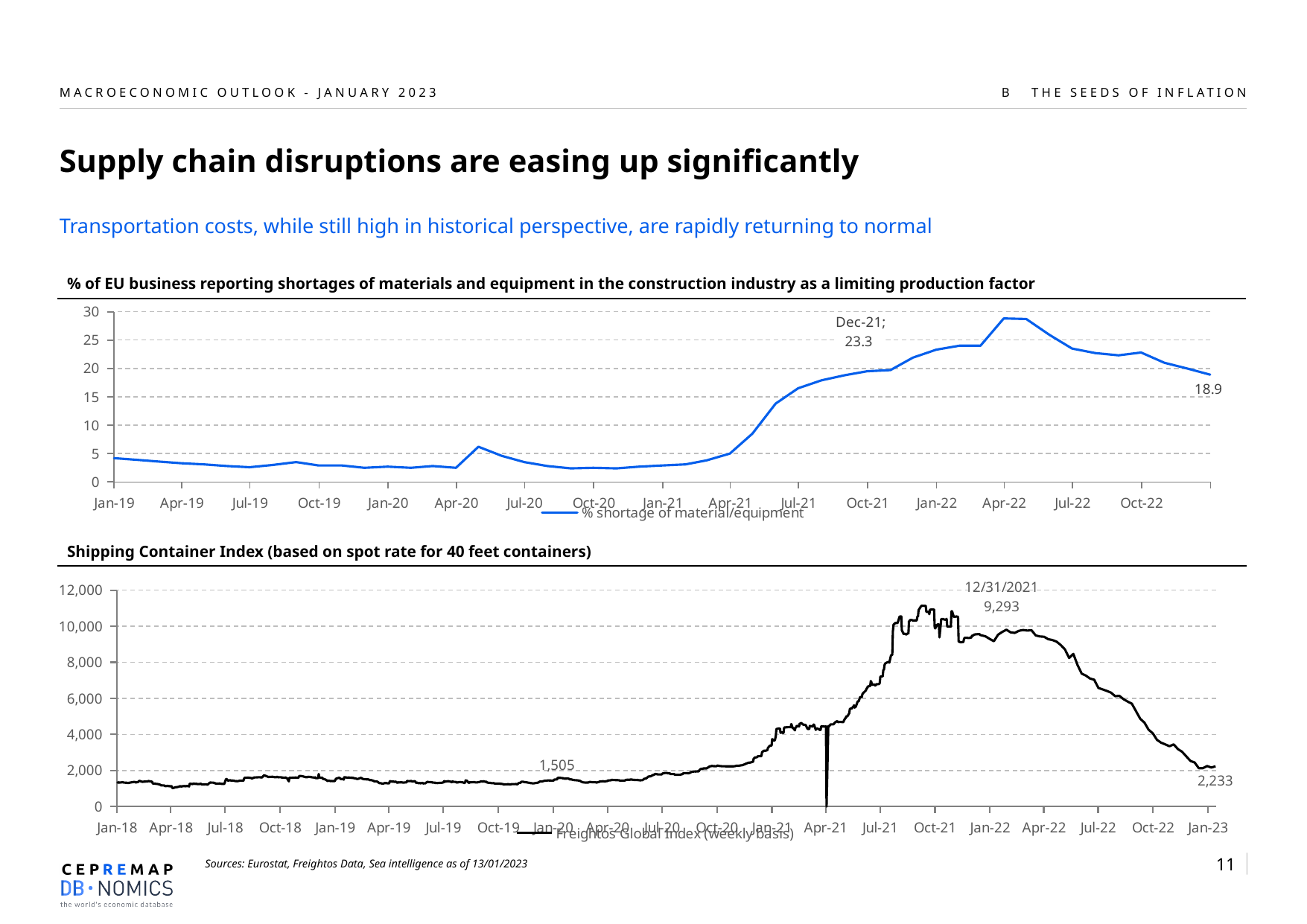
In the top chart (% of EU business reporting shortages), is the value at Apr-22 greater or less than 25? greater In the bottom chart (Shipping Container Index), what value is labelled for 12/31/2021? 9,293 In the bottom chart (Shipping Container Index), is the value at Jan-18 greater or less than 2,000? less In the top chart (% of EU business reporting shortages), is the value at Jan-19 greater or less than 5? less What is the legend entry of the top chart (% of EU business reporting shortages)? % shortage of material/equipment What kind of chart is the top chart (% of EU business reporting shortages)? Line chart In the top chart (% of EU business reporting shortages), what value is labelled for Dec-21? 23.3 In the top chart (% of EU business reporting shortages), do values rise or fall from Apr-22 to the end of the series? Fall In the top chart (% of EU business reporting shortages), what is the value labelled at the end of the series? 18.9 In the bottom chart (Shipping Container Index), what is the value labelled at the end of the series? 2,233 In the bottom chart (Shipping Container Index), what is the difference between the 12/31/2021 value and the final labelled value? 7,060 In the top chart (% of EU business reporting shortages), what is the difference between the Dec-21 value and the final labelled value? 4.4